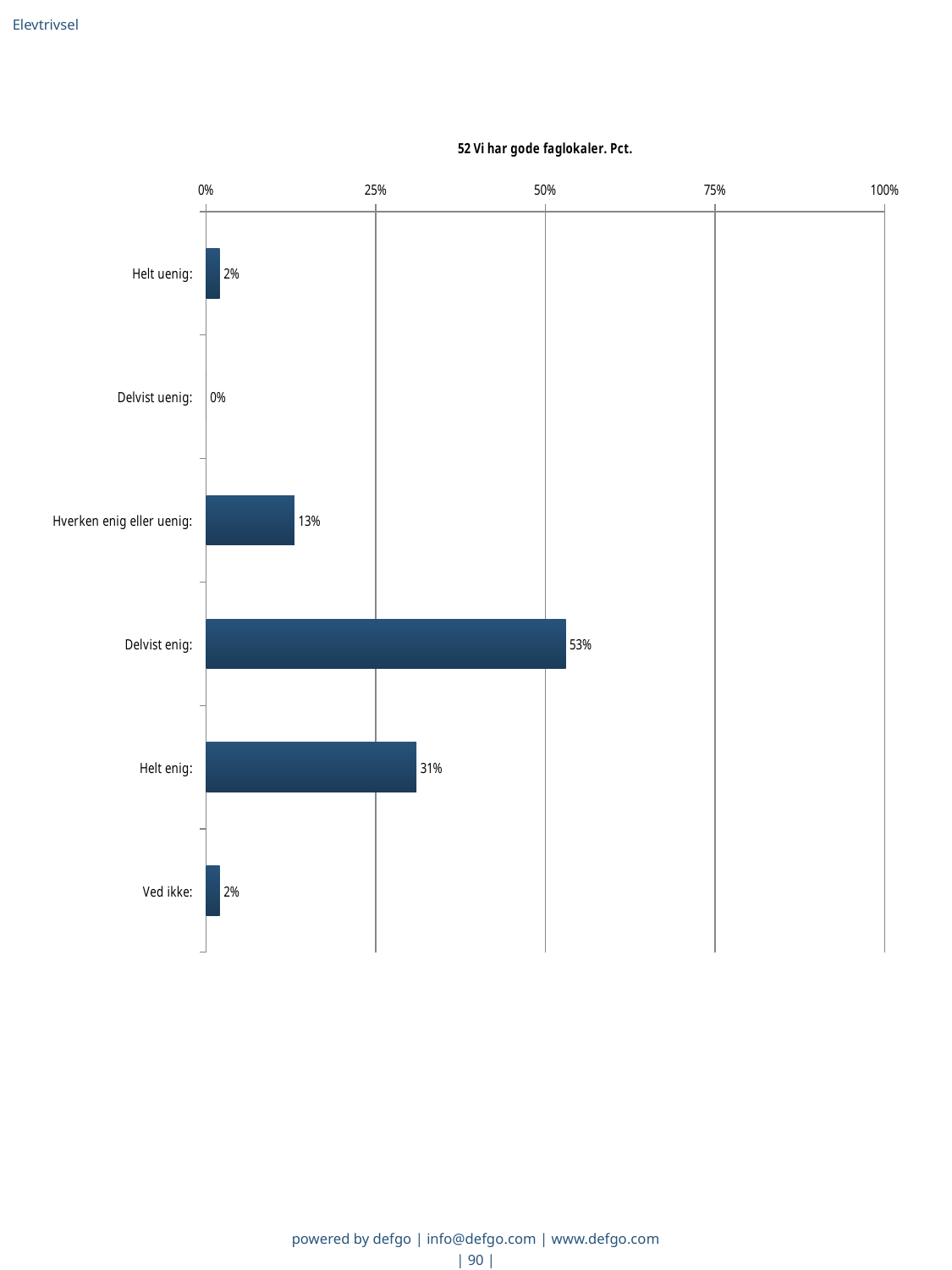
Which is larger, the value for "Helt enig" or the value for "Hverken enig eller uenig"? Helt enig What is the title of the chart? 52 Vi har gode faglokaler. Pct. What is the value for "Delvist uenig"? 0% How many categories are shown in the chart? 6 Which category has the lowest value? Delvist uenig Is the value for "Delvist enig" greater or less than 50%? greater What kind of chart is shown on the slide? bar chart What is the value for "Helt enig"? 31% What is the difference between the values for "Delvist enig" and "Helt enig"? 22% What is the value for "Hverken enig eller uenig"? 13% What is the value for "Delvist enig"? 53% Which category has the highest value? Delvist enig